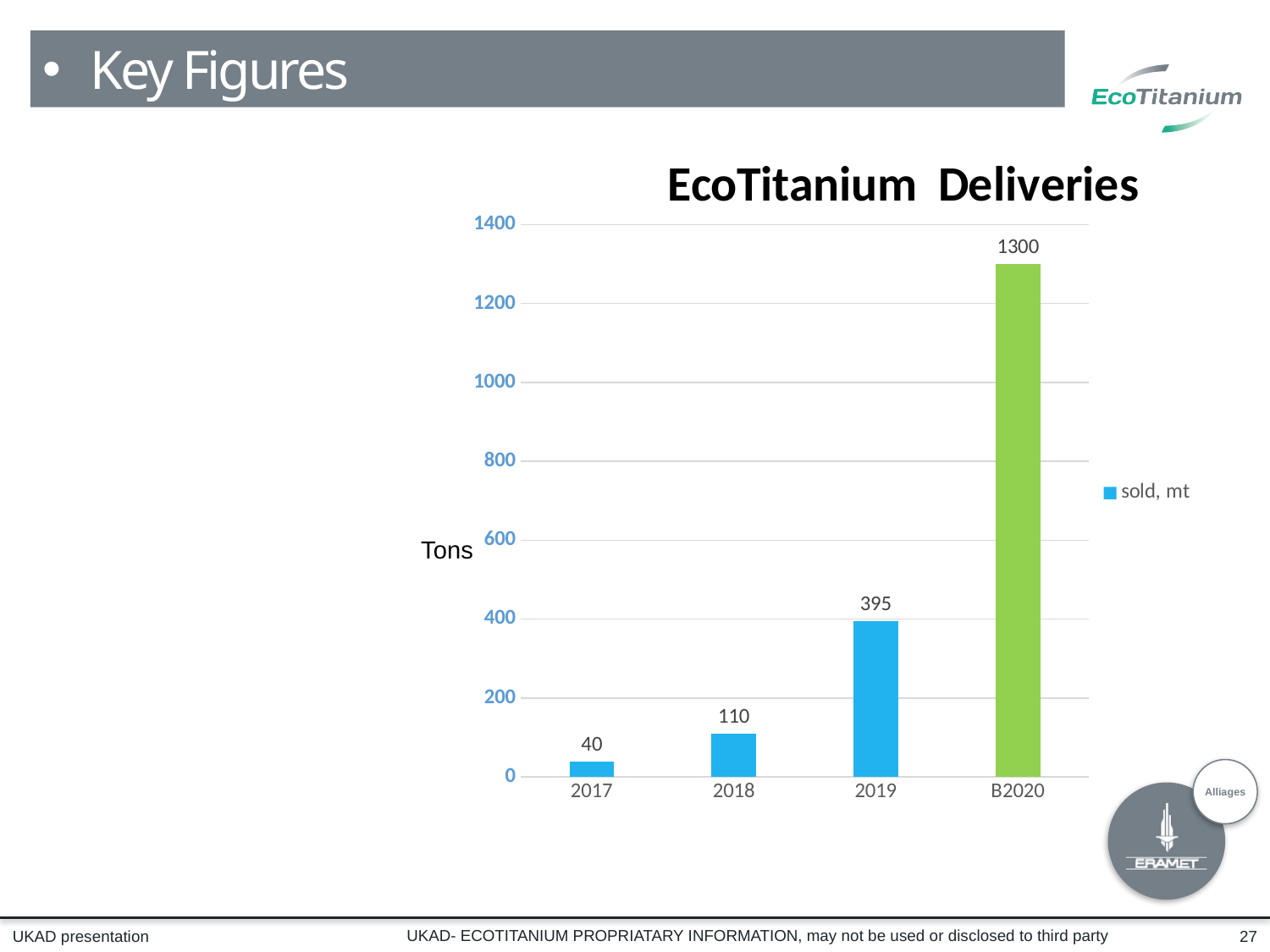
What is the difference between the values for 2019 and 2018? 285 What is the difference between the values for B2020 and 2019? 905 How many categories are shown on the x axis of the EcoTitanium Deliveries chart? 4 Which is larger, the value for 2018 or the value for 2017? 2018 What is the value for 2017 in the EcoTitanium Deliveries chart? 40 Which category has the highest value in the EcoTitanium Deliveries chart? B2020 What kind of chart is shown on the slide? bar chart Do the values rise or fall from 2017 to B2020? rise Is the value for 2019 greater or less than 200? greater What is the value for 2019 in the EcoTitanium Deliveries chart? 395 What is the value for B2020 in the EcoTitanium Deliveries chart? 1300 Which category has the lowest value in the EcoTitanium Deliveries chart? 2017